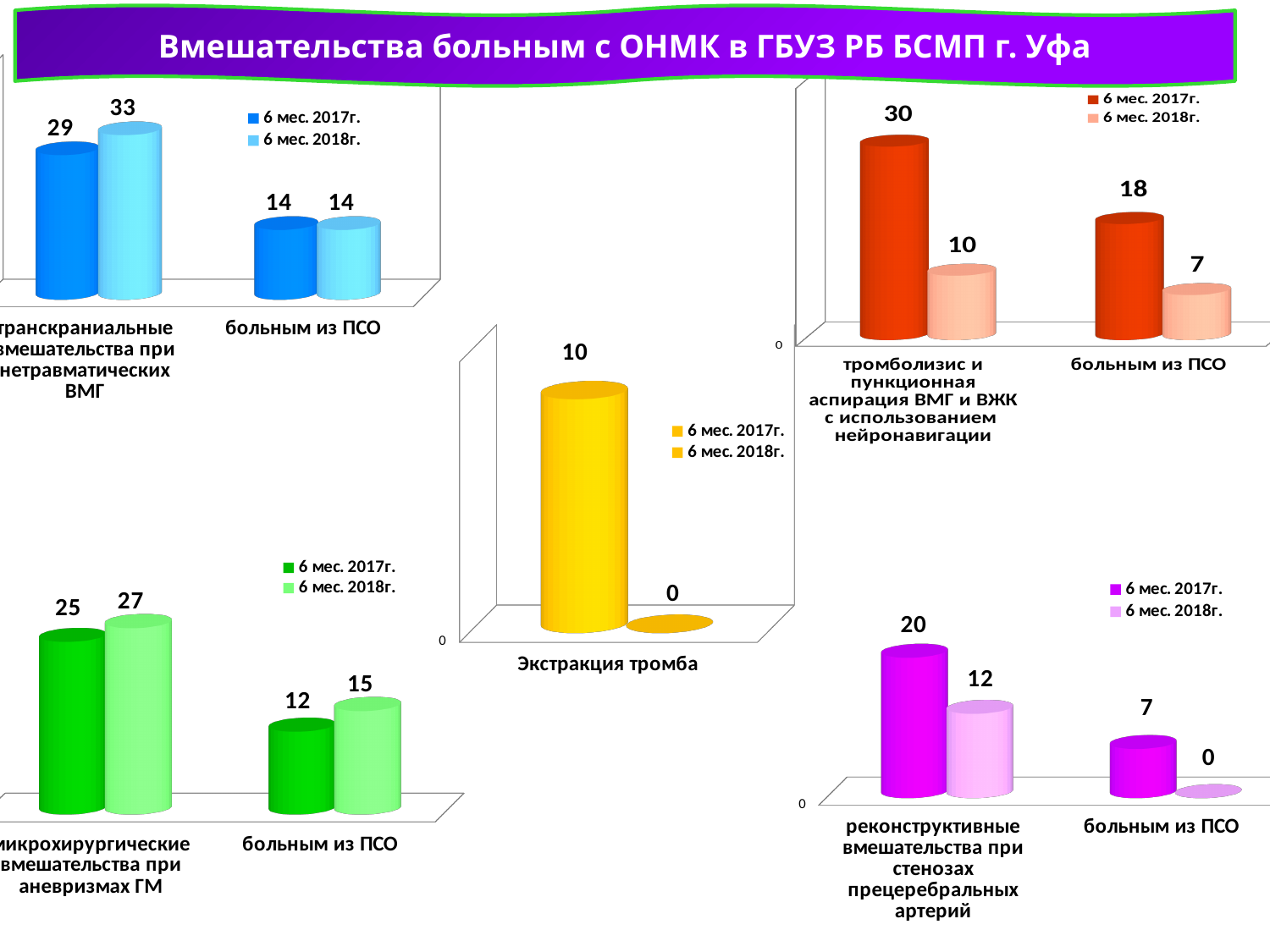
In the bottom-left green chart, what is the difference between the 6 мес. 2018г. and 6 мес. 2017г. values for больным из ПСО? 3 In the top-right red chart, which is larger for больным из ПСО: the 6 мес. 2017г. value or the 6 мес. 2018г. value? 6 мес. 2017г. What kind of chart is the center chart titled Экстракция тромба? Bar chart In the top-left blue chart, what is the difference between the 6 мес. 2018г. and 6 мес. 2017г. values for транскраниальные вмешательства при нетравматических ВМГ? 4 How many series does the legend of the top-right red chart list? 2 In the bottom-right magenta chart, what is the value for 6 мес. 2017г. for реконструктивные вмешательства при стенозах прецеребральных артерий? 20 In the center yellow chart titled Экстракция тромба, what is the value for 6 мес. 2018г.? 0 In the center yellow chart titled Экстракция тромба, what is the difference between the 6 мес. 2017г. and 6 мес. 2018г. values? 10 In the bottom-right magenta chart, which category has the lowest value for 6 мес. 2018г.? больным из ПСО In the top-right red chart, what is the value for 6 мес. 2017г. for тромболизис и пункционная аспирация ВМГ и ВЖК с использованием нейронавигации? 30 In the bottom-left green chart, what is the value for 6 мес. 2018г. for микрохирургические вмешательства при аневризмах ГМ? 27 In the top-left blue chart, what is the value for 6 мес. 2018г. for the category больным из ПСО? 14